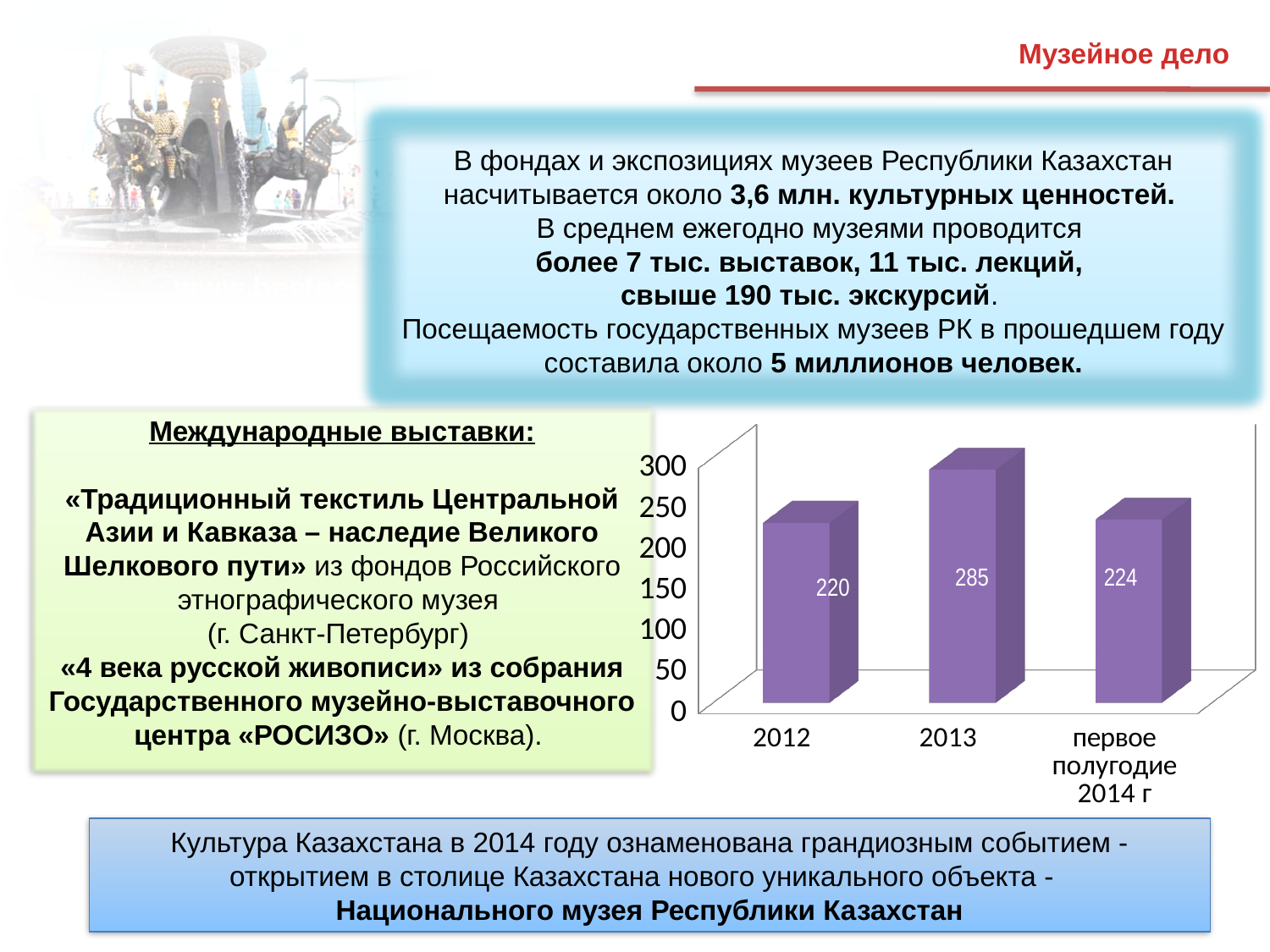
What is the value for 2012? 220 What is the value for первое полугодие 2014 г? 224 What kind of chart is shown on the slide? bar chart How many categories are shown on the x axis? 3 What is the difference between the values for 2013 and 2012? 65 Is the value for 2013 greater or less than 250? greater Which category has the highest value? 2013 What colour are the bars in the chart? purple Which category has the lowest value? 2012 Which is larger, the value for 2013 or the value for первое полугодие 2014 г? 2013 What is the value for 2013? 285 What is the difference between the values for 2013 and первое полугодие 2014 г? 61